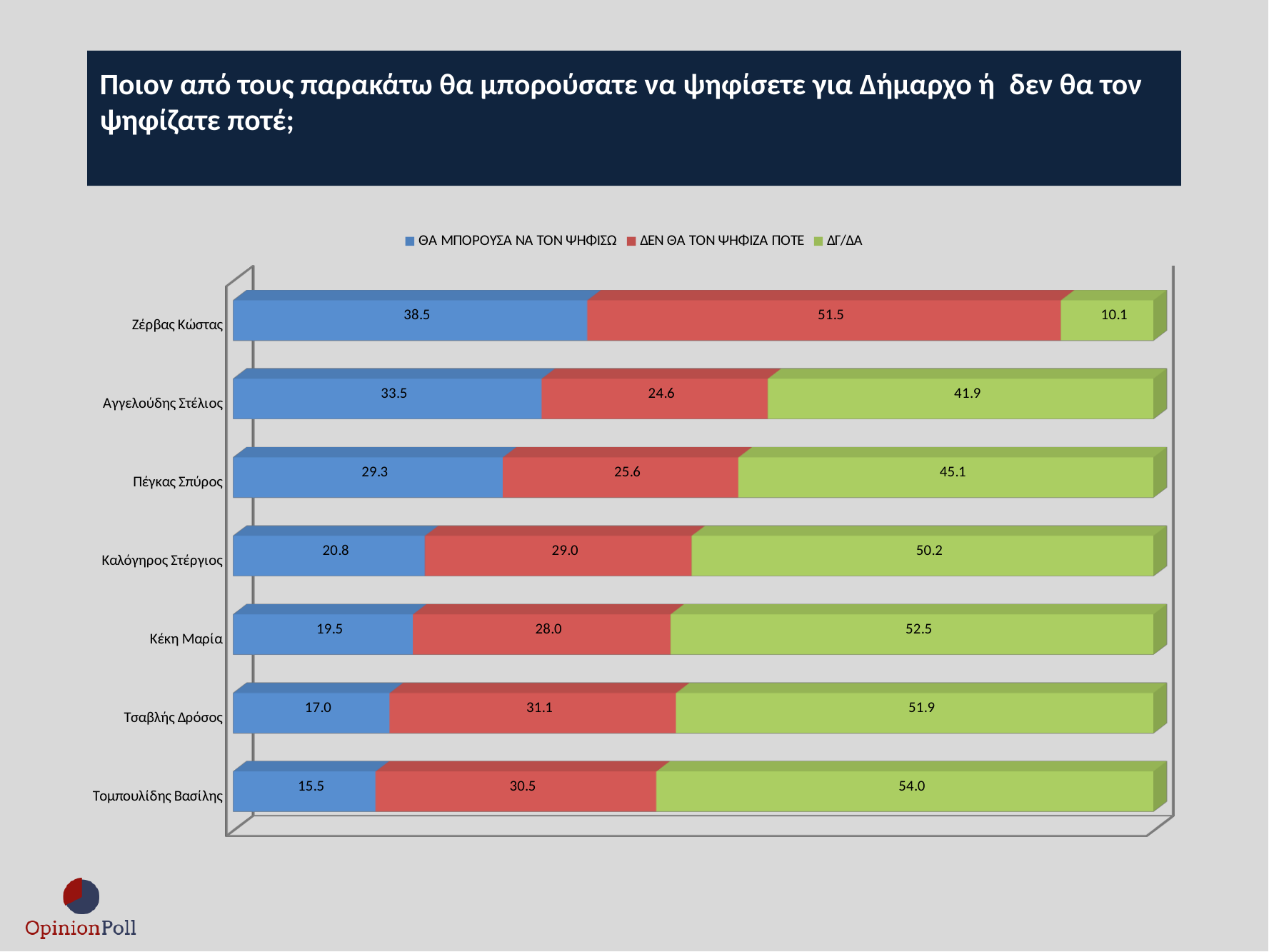
Which candidate has the lowest ΔΓ/ΔΑ value? Ζέρβας Κώστας What is the total of the stacked bar for Αγγελούδης Στέλιος? 100.0 Which candidate has the highest ΘΑ ΜΠΟΡΟΥΣΑ ΝΑ ΤΟΝ ΨΗΦΙΣΩ value? Ζέρβας Κώστας What is the difference between the ΔΕΝ ΘΑ ΤΟΝ ΨΗΦΙΖΑ ΠΟΤΕ values for Ζέρβας Κώστας and Αγγελούδης Στέλιος? 26.9 How many candidates are shown in the chart? 7 Which candidate has the lowest ΘΑ ΜΠΟΡΟΥΣΑ ΝΑ ΤΟΝ ΨΗΦΙΣΩ value? Τομπουλίδης Βασίλης What is the ΔΓ/ΔΑ value for Πέγκας Σπύρος? 45.1 What is the value of ΔΕΝ ΘΑ ΤΟΝ ΨΗΦΙΖΑ ΠΟΤΕ for Τσαβλής Δρόσος? 31.1 What kind of chart is shown on the slide? Stacked bar chart Which is larger: the ΔΓ/ΔΑ value for Κέκη Μαρία or for Καλόγηρος Στέργιος? Κέκη Μαρία What is the value of ΘΑ ΜΠΟΡΟΥΣΑ ΝΑ ΤΟΝ ΨΗΦΙΣΩ for Ζέρβας Κώστας? 38.5 How many series does the legend list? 3